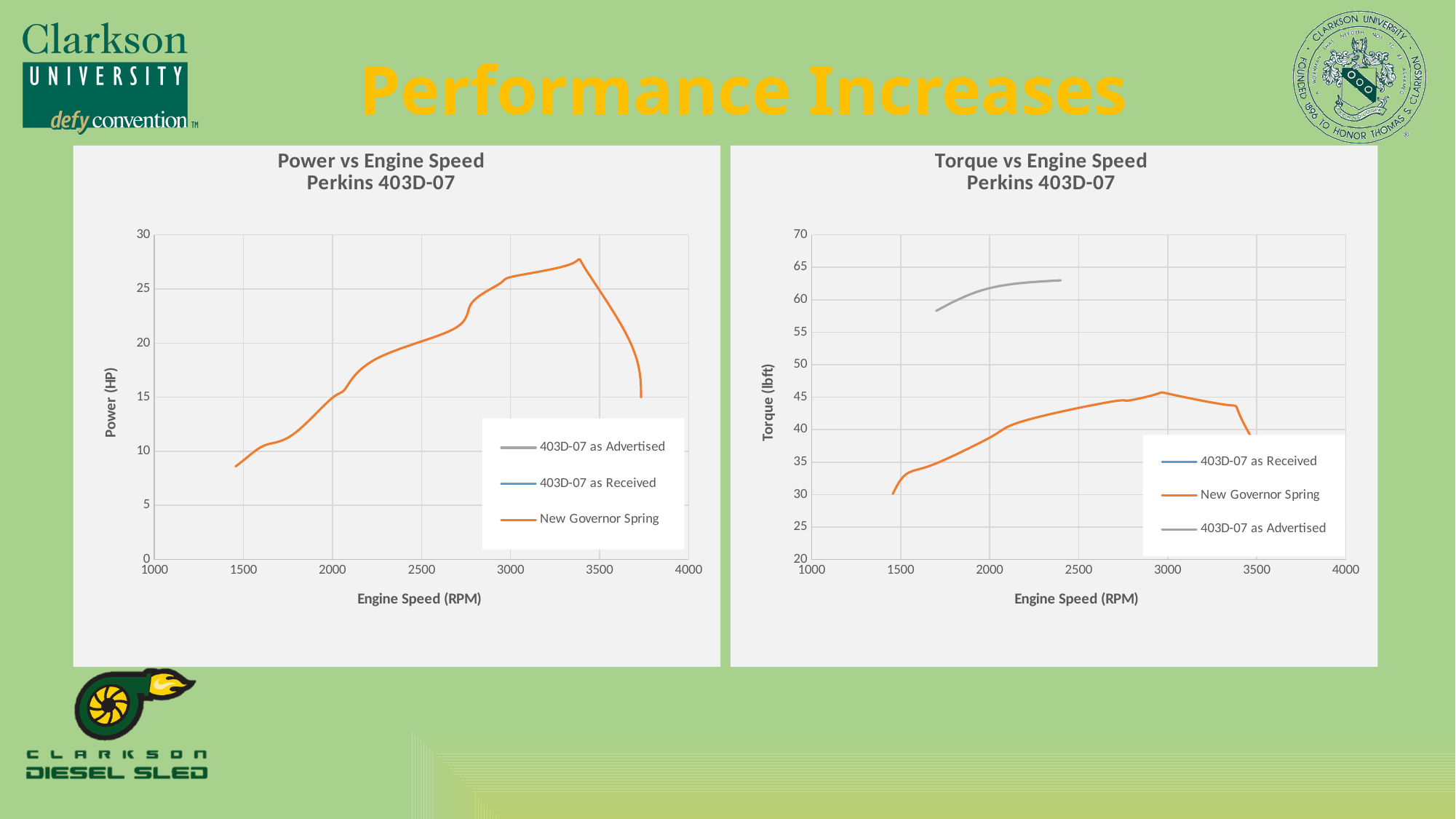
On the "Torque vs Engine Speed" chart, does the 403D-07 as Advertised line rise or fall as engine speed increases? rise What is the x-axis label of the "Power vs Engine Speed" chart? Engine Speed (RPM) On the "Power vs Engine Speed" chart, is the New Governor Spring power at 3000 RPM greater or less than 25? greater On the "Torque vs Engine Speed" chart, at 2000 RPM which series shows higher torque, 403D-07 as Advertised or New Governor Spring? 403D-07 as Advertised How many series does the legend of the "Power vs Engine Speed" chart list? 3 On the "Power vs Engine Speed" chart, does the New Governor Spring line rise or fall between 1500 and 3000 RPM? rise What kind of chart is the "Power vs Engine Speed" chart on the left? line chart What is the y-axis label of the "Torque vs Engine Speed" chart? Torque (lbft) How many series does the legend of the "Torque vs Engine Speed" chart list? 3 On the "Torque vs Engine Speed" chart, is the 403D-07 as Advertised torque at 2000 RPM greater or less than 60? greater On the "Power vs Engine Speed" chart, is the New Governor Spring power at 1500 RPM greater or less than 10? less